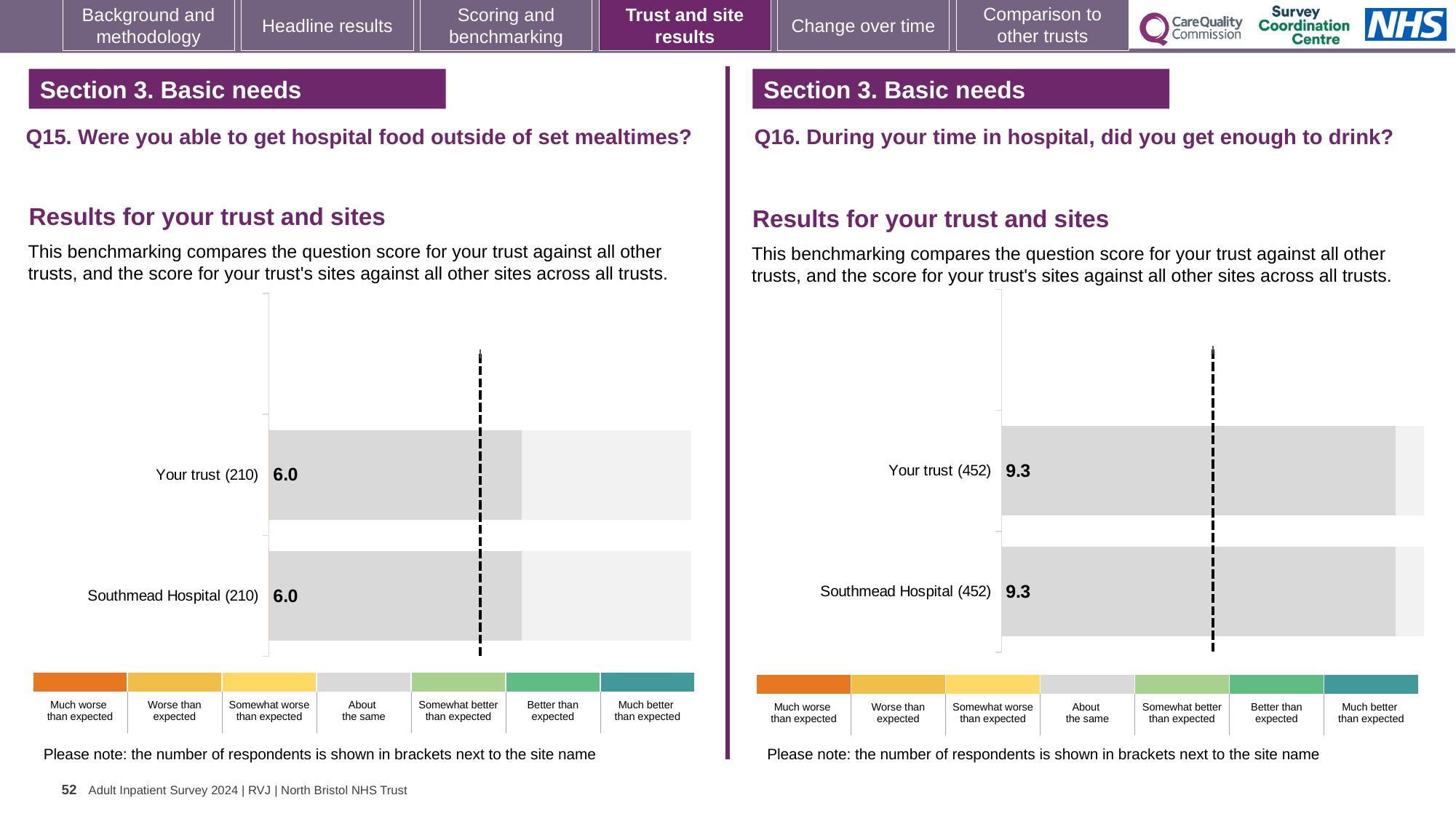
On the Q16 chart (right), what is the score for Your trust? 9.3 Is the score for Your trust on the Q16 chart (right) larger than the score for Your trust on the Q15 chart (left)? Yes What type of chart is used on the Q15 chart (left)? Bar chart On the Q16 chart (right), how many respondents are shown in brackets for Your trust? 452 On the Q15 chart (left), how many respondents are shown in brackets for Southmead Hospital? 210 How many bars are plotted on the Q16 chart (right)? 2 On the Q16 chart (right), what is the score for Southmead Hospital? 9.3 On the Q15 chart (left), what is the score for Southmead Hospital? 6.0 On the Q15 chart (left), what is the score for Your trust? 6.0 On the Q15 chart (left), what is the difference between the scores for Your trust and Southmead Hospital? 0.0 On the Q16 chart (right), what is the difference between the scores for Your trust and Southmead Hospital? 0.0 How many bars are plotted on the Q15 chart (left)? 2